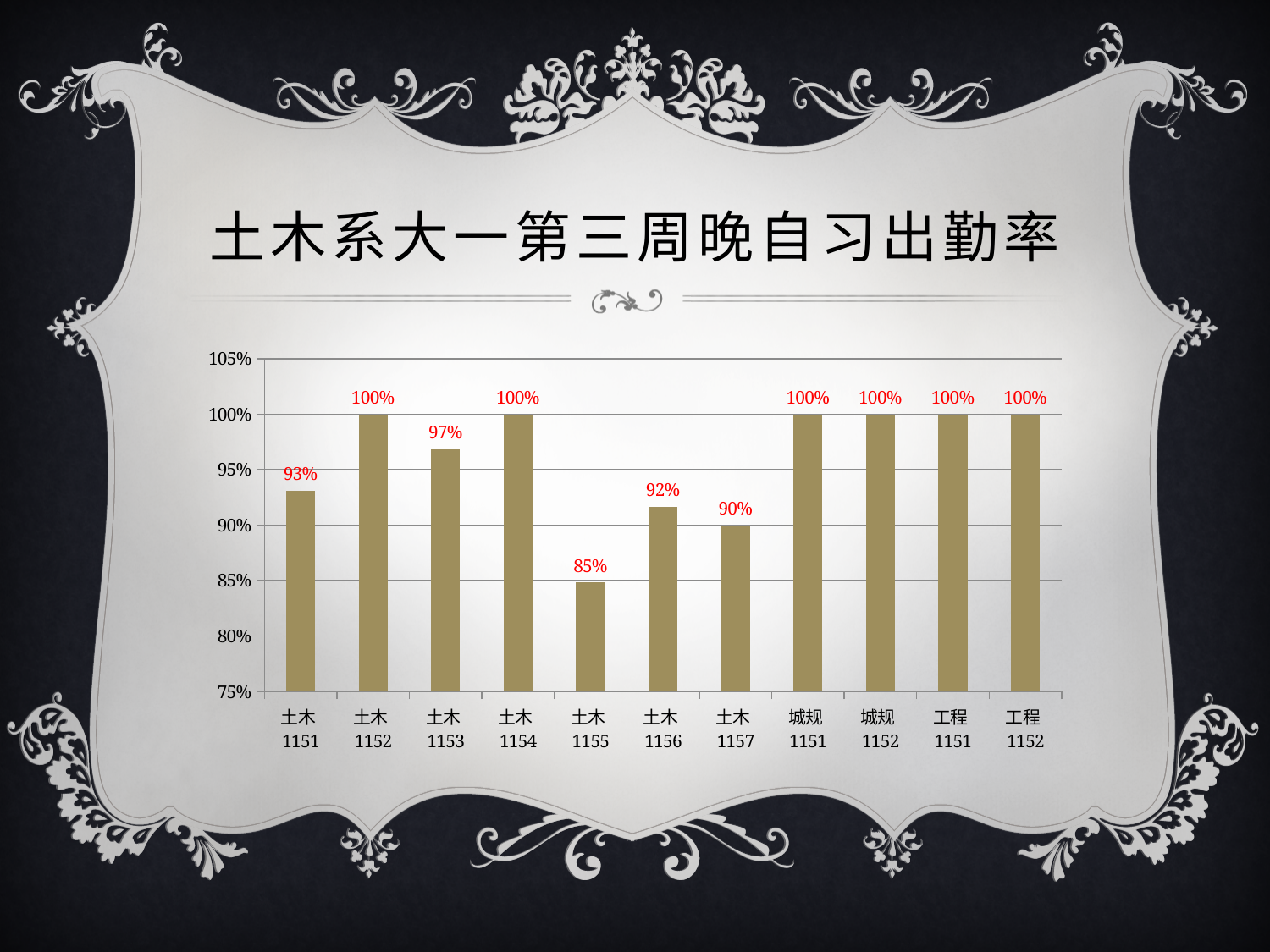
What is the attendance rate for 城规1152? 100% Which is higher, the attendance rate for 土木1156 or 土木1157? 土木1156 What is the attendance rate for 土木1153? 97% What is the attendance rate for 土木1155? 85% How many classes are shown on the x axis? 11 What kind of chart is shown on the slide? bar chart What is the attendance rate for 土木1151? 93% What is the difference between the attendance rates of 土木1153 and 土木1157? 7% Which class has the lowest attendance rate? 土木1155 What is the difference between the attendance rates of 土木1152 and 土木1155? 15% What is the title of the slide? 土木系大一第三周晚自习出勤率 Is the value for 土木1151 greater or less than 90%? greater